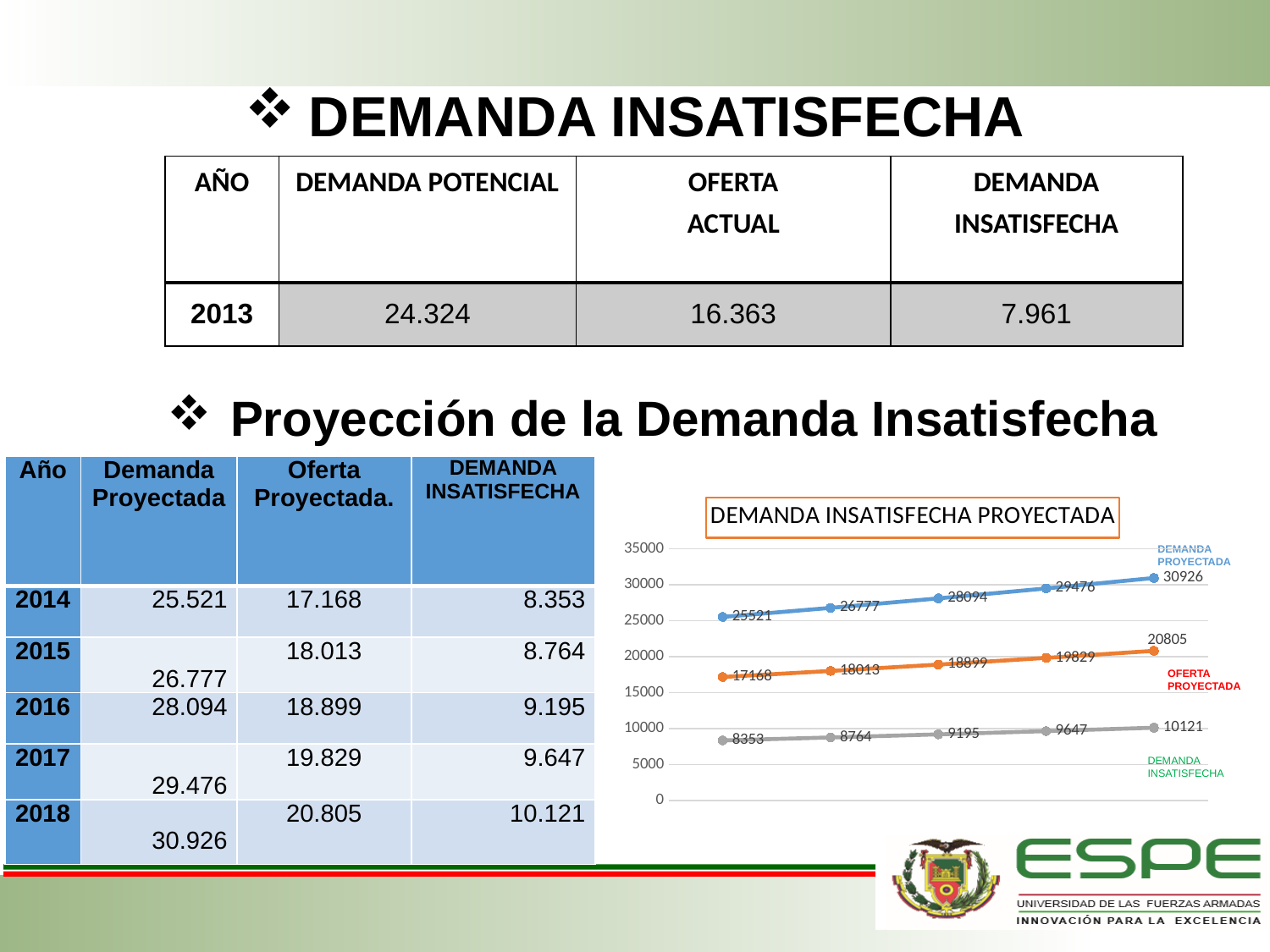
How many series does the chart plot? 3 Which series has the highest values in the chart? DEMANDA PROYECTADA Which series has the lowest values in the chart? DEMANDA INSATISFECHA How many data points does each line in the chart have? 5 What type of chart is shown on the slide? line chart What is the last (rightmost) value of the DEMANDA INSATISFECHA series in the chart? 10121 What is the difference between the last and first values of the DEMANDA PROYECTADA series in the chart? 5405 What is the first (leftmost) value of the OFERTA PROYECTADA series in the chart? 17168 What is the title of the chart? DEMANDA INSATISFECHA PROYECTADA What is the last (rightmost) value of the DEMANDA PROYECTADA series in the chart? 30926 Do the values of the OFERTA PROYECTADA series rise or fall from left to right in the chart? rise Is the last value of the OFERTA PROYECTADA series greater or less than 20000? greater